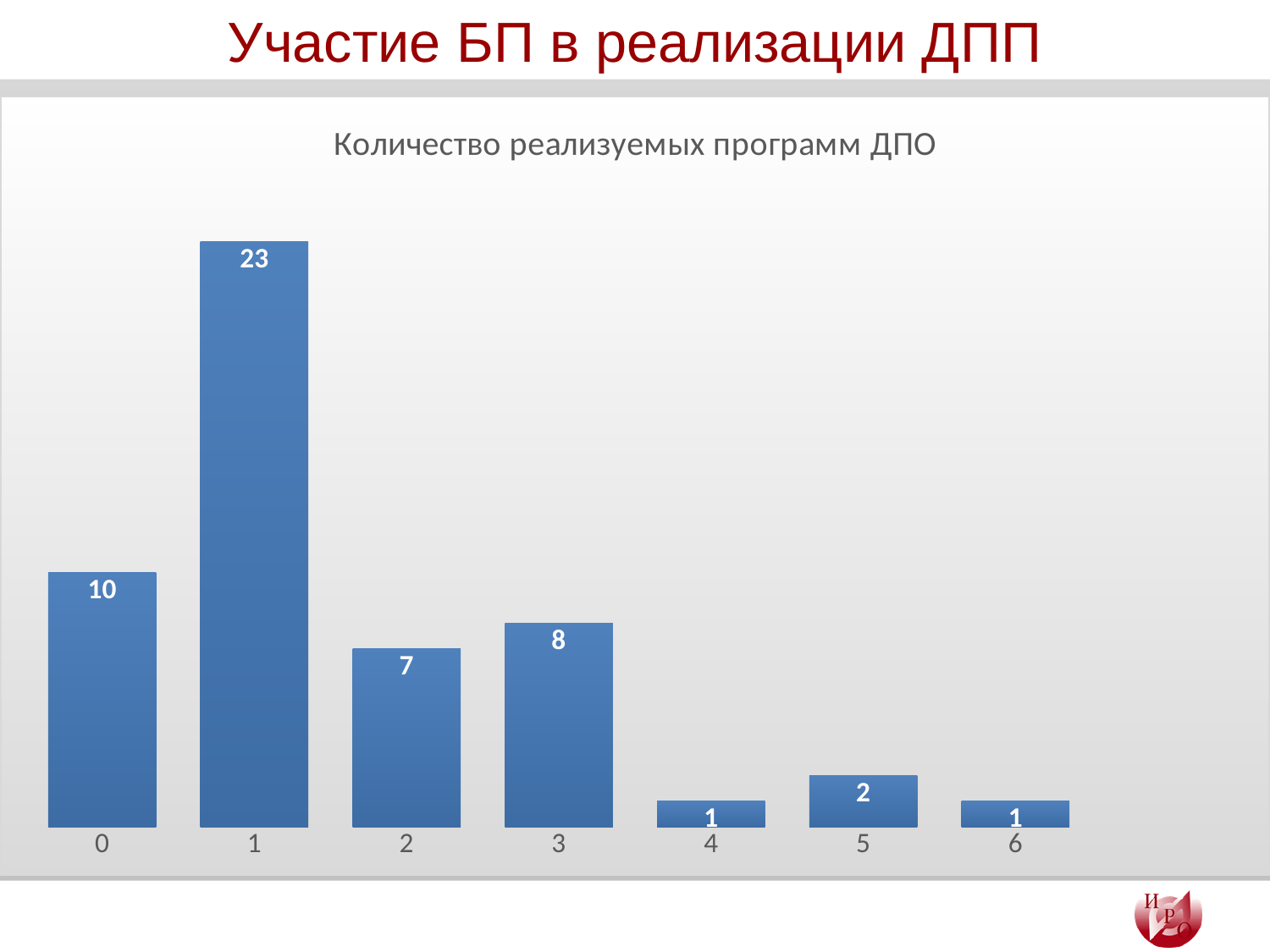
What is the value for category 0? 10 What is the value for category 5? 2 How many categories are shown on the x axis? 7 What is the value for category 3? 8 What colour are the bars in the chart? blue Which category has the highest value? 1 What is the value for category 1? 23 What is the title of the chart? Количество реализуемых программ ДПО What kind of chart is shown on the slide? bar chart What is the difference between the values for categories 1 and 0? 13 What is the difference between the values for categories 3 and 2? 1 Which is larger, the value for category 2 or the value for category 3? 3